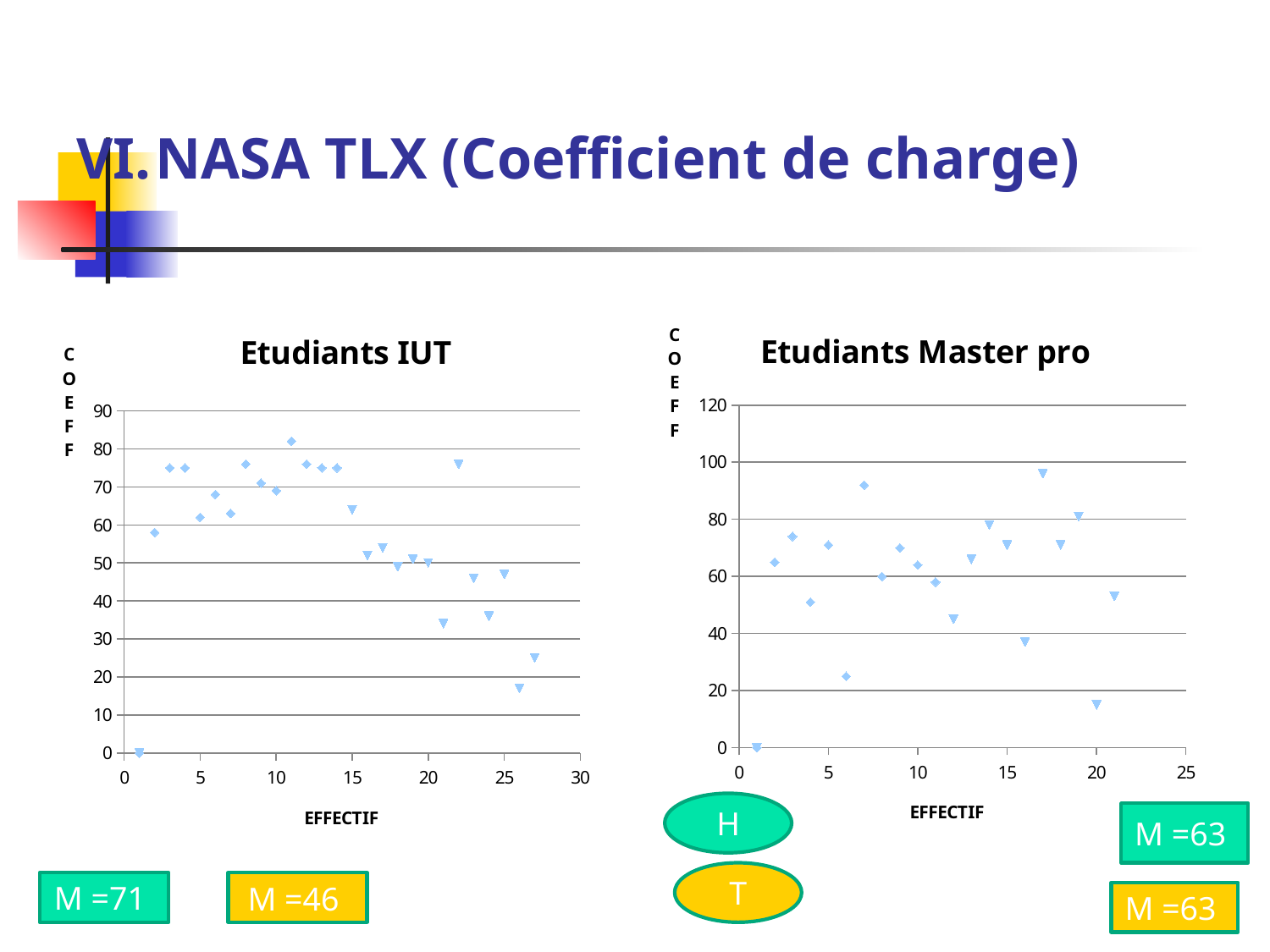
In the "Etudiants Master pro" chart, is the value at x = 20 greater or less than 20? less In the "Etudiants IUT" chart, what is the label of the x axis? EFFECTIF In the "Etudiants IUT" chart, which is larger, the value at x = 3 or the value at x = 21? x = 3 What kind of chart is the "Etudiants IUT" chart? scatter chart In the "Etudiants IUT" chart, is the value at x = 11 greater or less than 80? greater In the "Etudiants IUT" chart, at which x value is the highest point plotted? 11 What is the title of the chart on the right of the slide? Etudiants Master pro In the "Etudiants IUT" chart, is the value at x = 26 greater or less than 20? less In the "Etudiants Master pro" chart, which is larger, the value at x = 7 or the value at x = 16? x = 7 In the "Etudiants IUT" chart, do the values generally rise or fall as x increases? fall